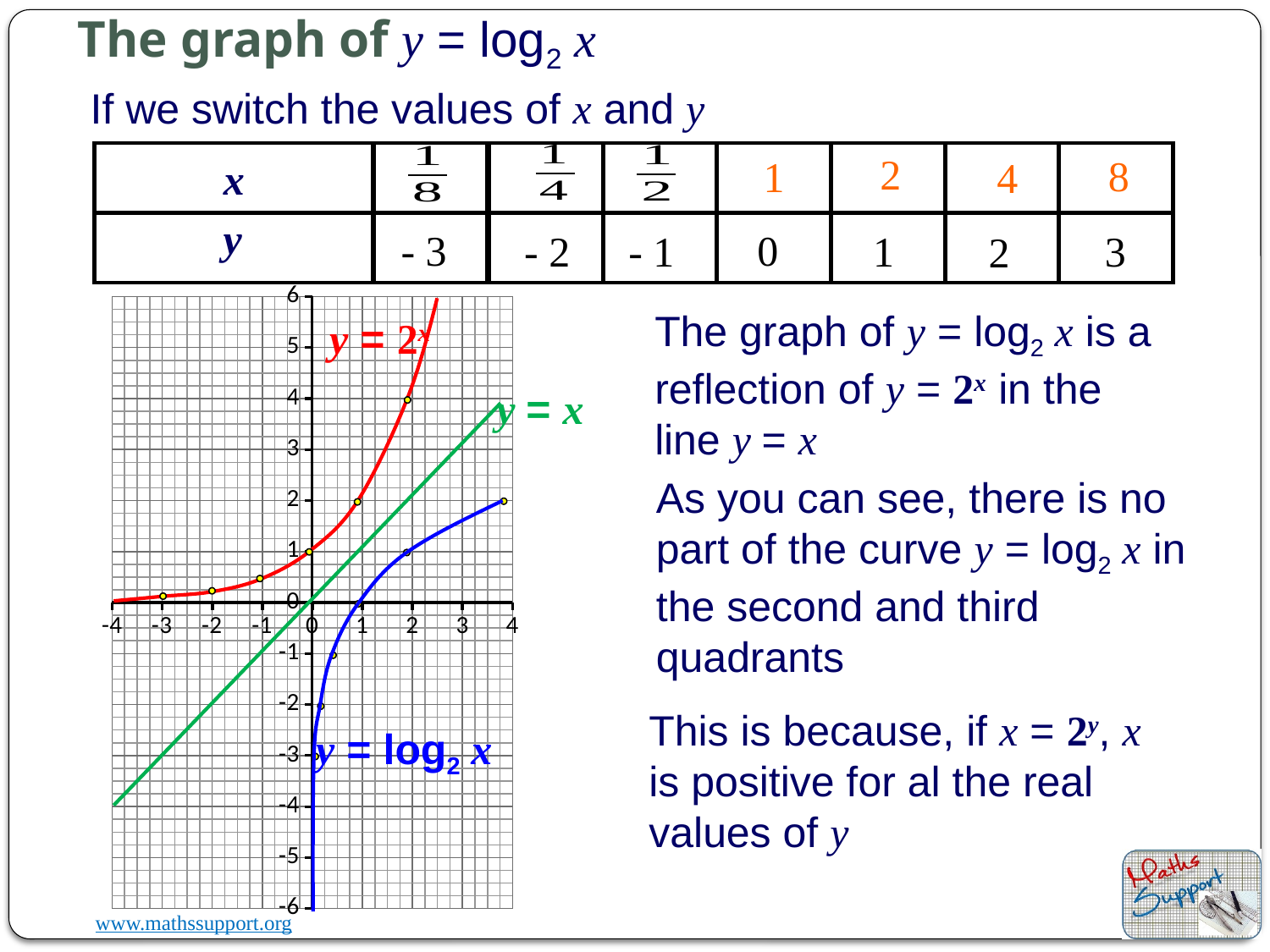
Which curve on the graph is drawn in red? y = 2^x What kind of chart is shown on the slide? line chart According to the table, what is y when x = 8? 3 Does the curve y = 2^x rise or fall as x increases? rise At what x value does the curve y = log2 x cross the x-axis? 1 How many curves are plotted on the graph? 3 At x = 2, which curve is higher, y = 2^x or y = log2 x? y = 2^x According to the table, what is y when x = 1/8? - 3 Which curve on the graph is drawn in blue? y = log2 x Does the curve y = log2 x rise or fall as x increases? rise At x = 2, is the value of y = log2 x greater or less than 2? less On the graph, what is the value of y = 2^x at x = 2? 4